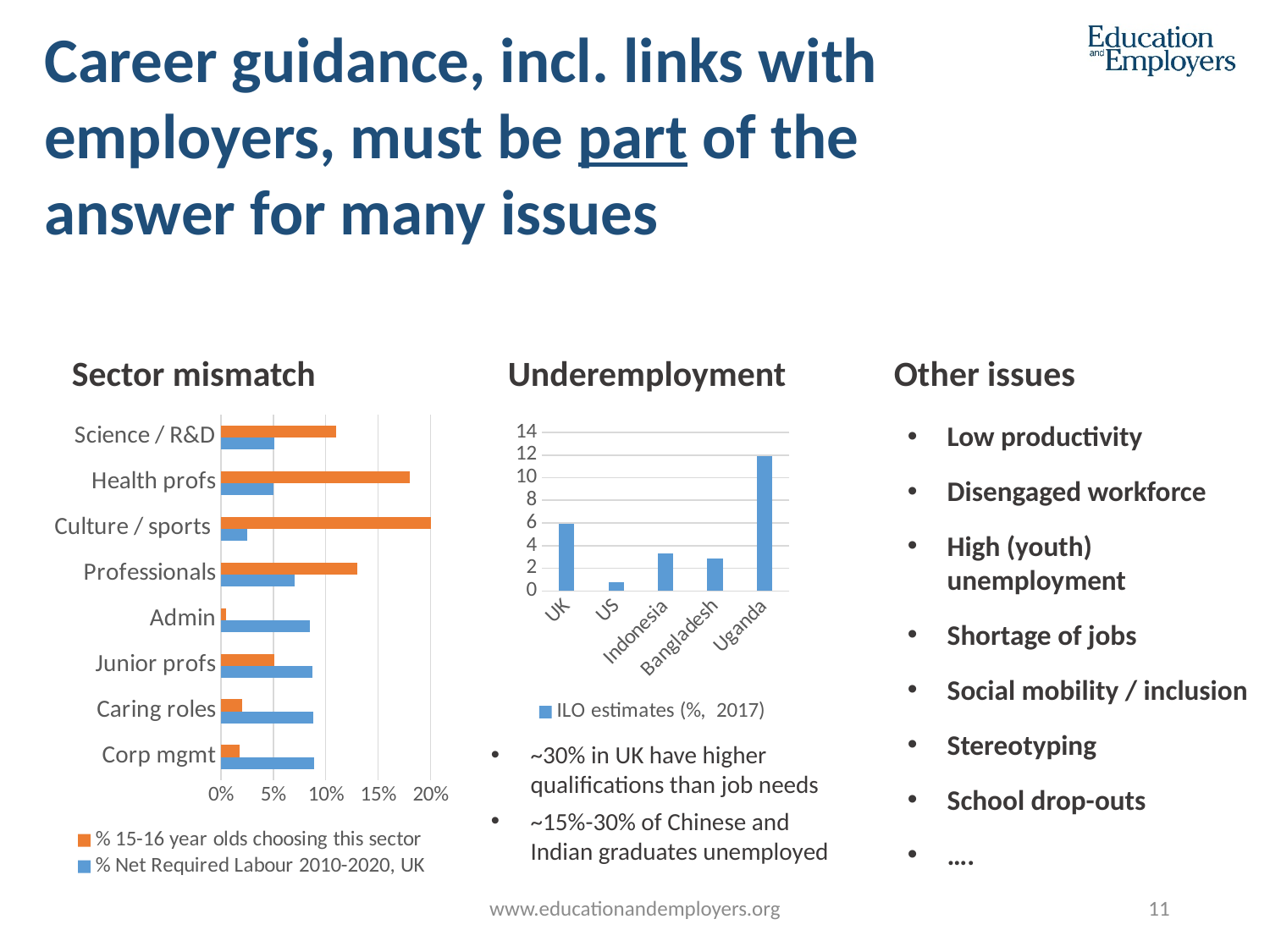
On the Sector mismatch chart, how many series does the legend list? 2 On the Sector mismatch chart, is the value for Corp mgmt in the % Net Required Labour 2010-2020, UK series greater or less than 5%? greater On the Underemployment chart, which country has the highest value? Uganda On the Underemployment chart, how many countries are shown? 5 On the Underemployment chart, which country has the lowest value? US On the Sector mismatch chart, is the value for Health profs in the % 15-16 year olds choosing this sector series greater or less than 15%? greater On the Sector mismatch chart, how many sectors are shown? 8 On the Underemployment chart, what is the legend entry for the plotted series? ILO estimates (%, 2017) On the Sector mismatch chart, which sector has the lowest value for % 15-16 year olds choosing this sector? Admin On the Sector mismatch chart, for Science / R&D, which series has the larger value? % 15-16 year olds choosing this sector On the Sector mismatch chart, which sector has the highest value for % 15-16 year olds choosing this sector? Culture / sports On the Sector mismatch chart, what kind of chart is used? bar chart